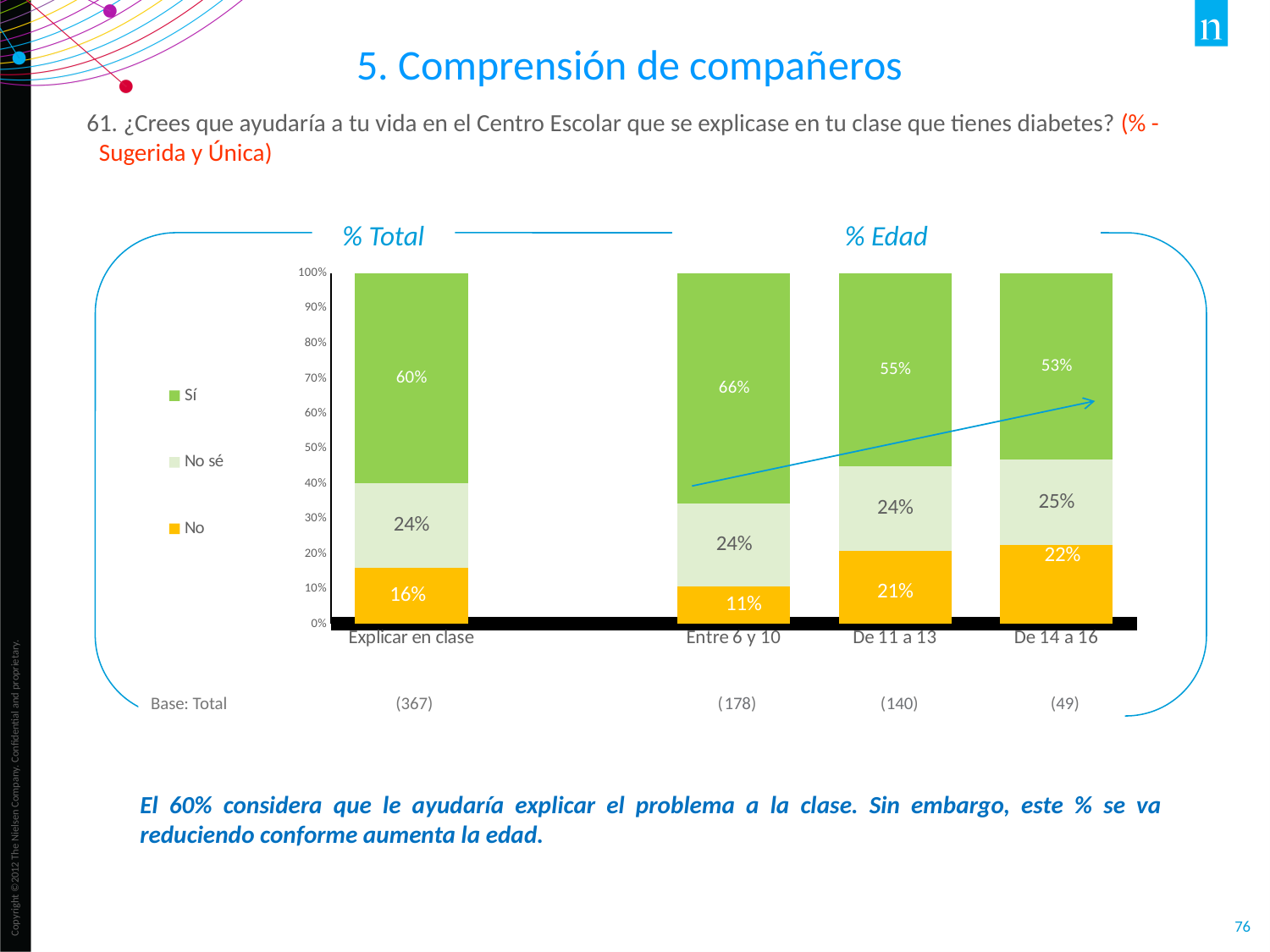
How many series does the legend list? 3 What is the 'No sé' value for the 'De 14 a 16' age group? 25% Which age group has the highest 'Sí' percentage? Entre 6 y 10 What is the 'No' value for the 'Entre 6 y 10' age group? 11% Which is larger: the 'No' value for 'De 11 a 13' or the 'No' value for 'Explicar en clase'? De 11 a 13 What kind of chart is shown on the slide? Stacked bar chart What is the difference between the 'Sí' value for 'Entre 6 y 10' and the 'Sí' value for 'De 14 a 16'? 13% How many bars are plotted in the chart? 4 What is the 'Sí' value for the 'De 11 a 13' age group? 55% Across the age groups from 'Entre 6 y 10' to 'De 14 a 16', does the 'Sí' percentage rise or fall? Fall What percentage of respondents in the 'Explicar en clase' bar answered 'Sí'? 60% Which age group has the lowest 'No' percentage? Entre 6 y 10